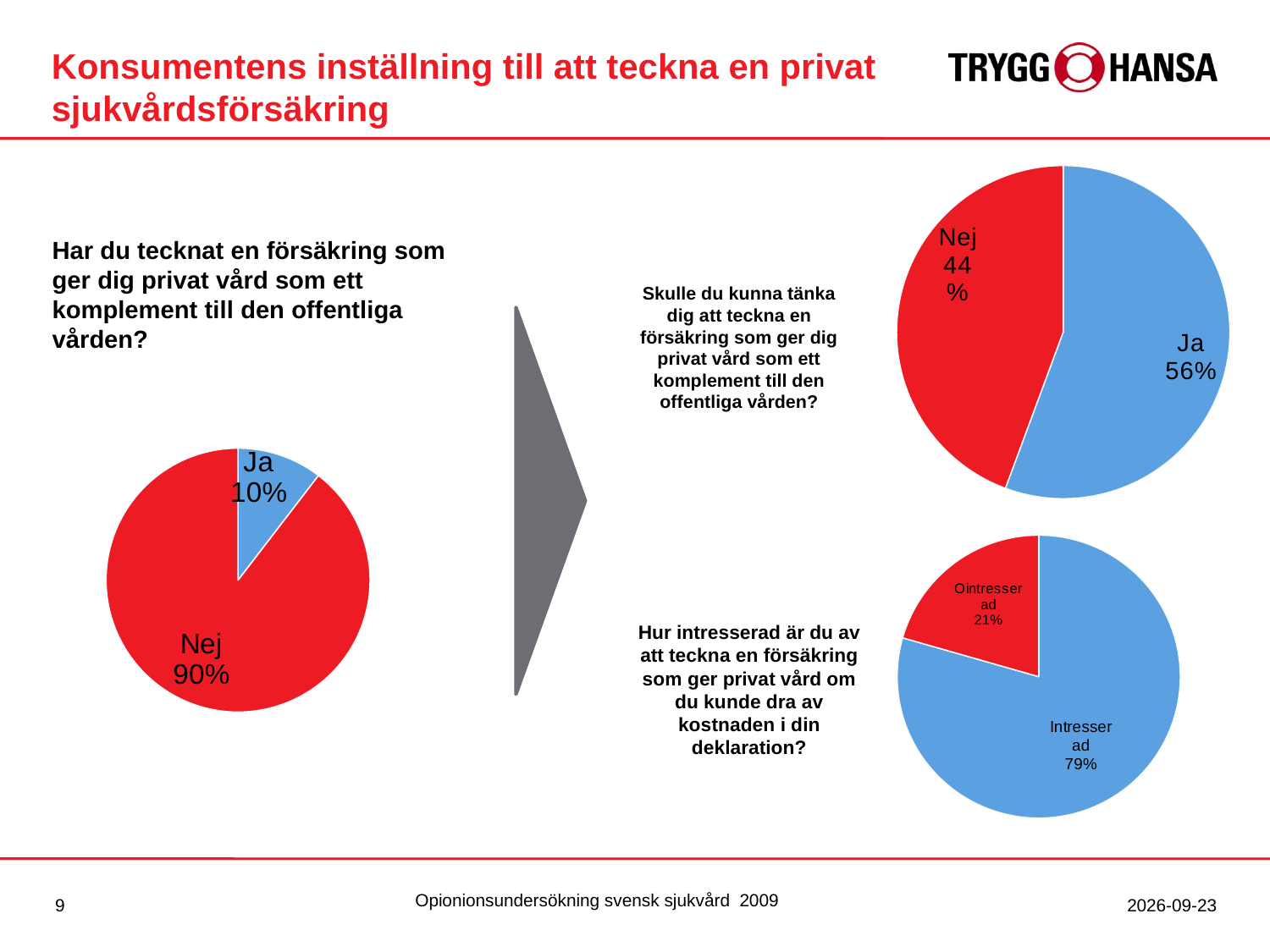
In the top-right pie chart, what share of respondents answered "Ja"? 56% In the bottom-right pie chart, what share of respondents are "Intresserad"? 79% In the pie chart on the left of the slide, what share of respondents answered "Nej"? 90% In the pie chart on the left of the slide, what is the difference between the "Nej" and "Ja" shares? 80% In the pie chart on the left of the slide, what share of respondents answered "Ja"? 10% In the top-right pie chart, what share of respondents answered "Nej"? 44% What type of chart is used for the three charts on this slide? Pie chart In the bottom-right pie chart, which slice is the smallest? Ointresserad In the top-right pie chart, which is larger, the "Ja" slice or the "Nej" slice? Ja In the pie chart on the left of the slide, which slice is the largest? Nej In the bottom-right pie chart, what share of respondents are "Ointresserad"? 21% In the top-right pie chart, what is the difference between the "Ja" and "Nej" shares? 12%